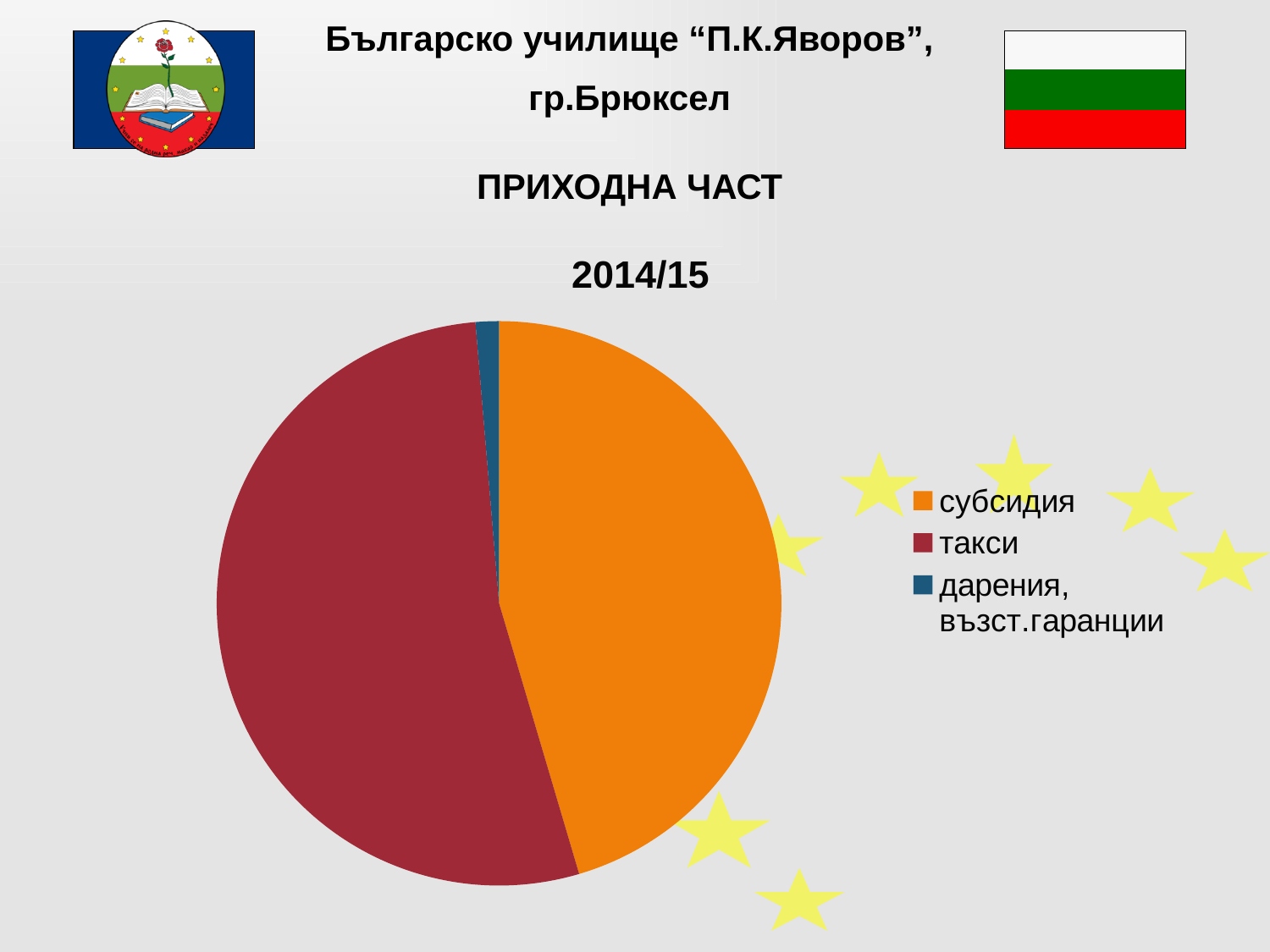
Does the субсидия slice take up more or less than half of the pie? less Which category has the largest slice of the pie chart? такси How many slices does the pie chart have? 3 How many entries does the legend of the pie chart list? 3 What is the title of the chart? 2014/15 What kind of chart is shown on the slide? pie chart Which slice is larger, субсидия or такси? такси Which category has the smallest slice of the pie chart? дарения, възст.гаранции Which slice is larger, такси or дарения, възст.гаранции? такси What colour is the такси slice in the pie chart? red